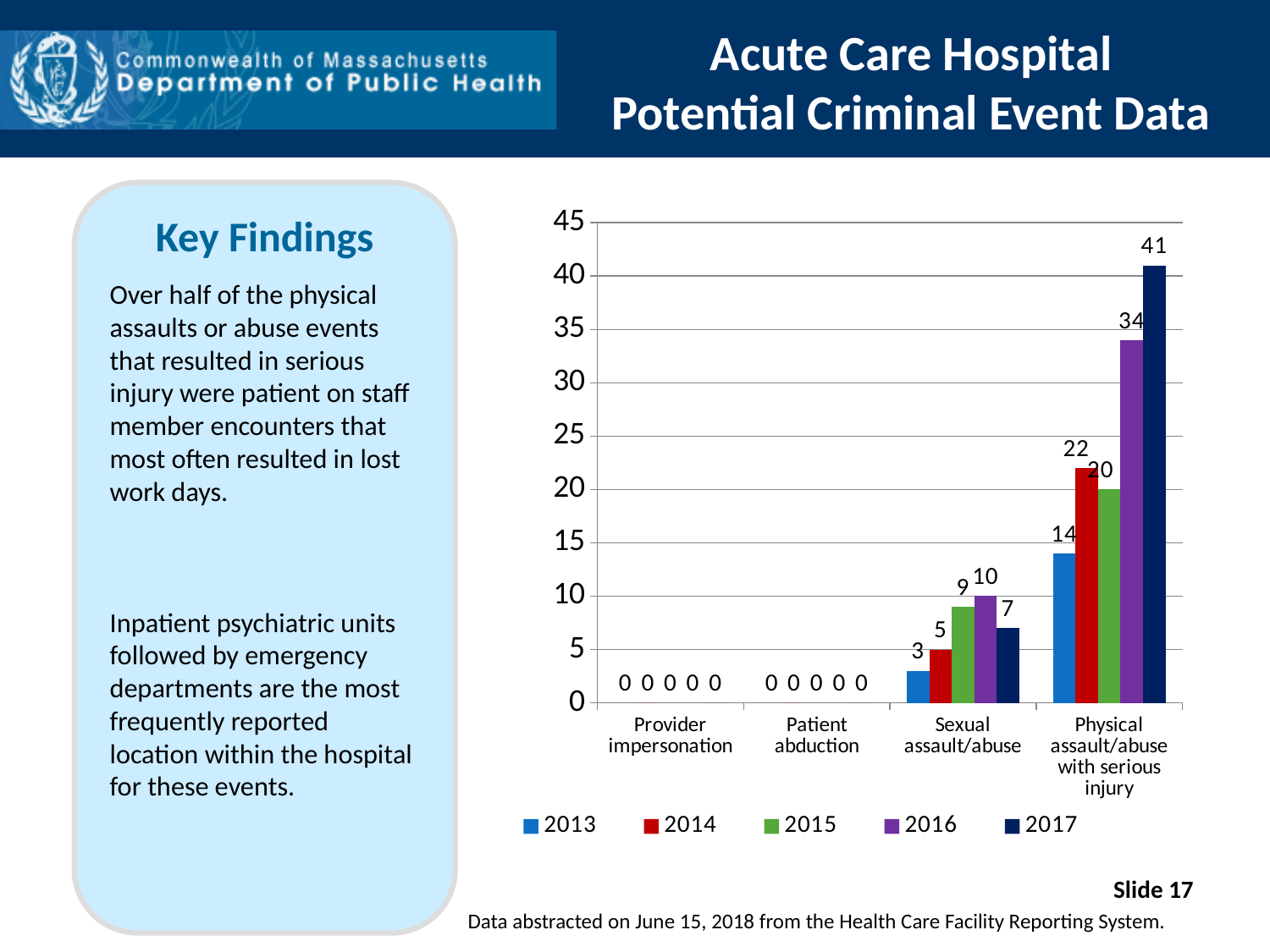
What is the value for 2016 in the Physical assault/abuse with serious injury category? 34 Which is larger in the Sexual assault/abuse category: the 2015 value or the 2016 value? 2016 What kind of chart is shown on the slide? Bar chart What is the value for 2017 in the Physical assault/abuse with serious injury category? 41 Which year has the highest value in the Physical assault/abuse with serious injury category? 2017 How many series does the legend list? 5 How many categories are shown on the x axis? 4 What is the value for every year in the Patient abduction category? 0 Which year has the lowest value in the Sexual assault/abuse category? 2013 What is the difference between the 2017 and 2016 values for Physical assault/abuse with serious injury? 7 What is the value for 2017 in the Sexual assault/abuse category? 7 What is the value for 2013 in the Sexual assault/abuse category? 3